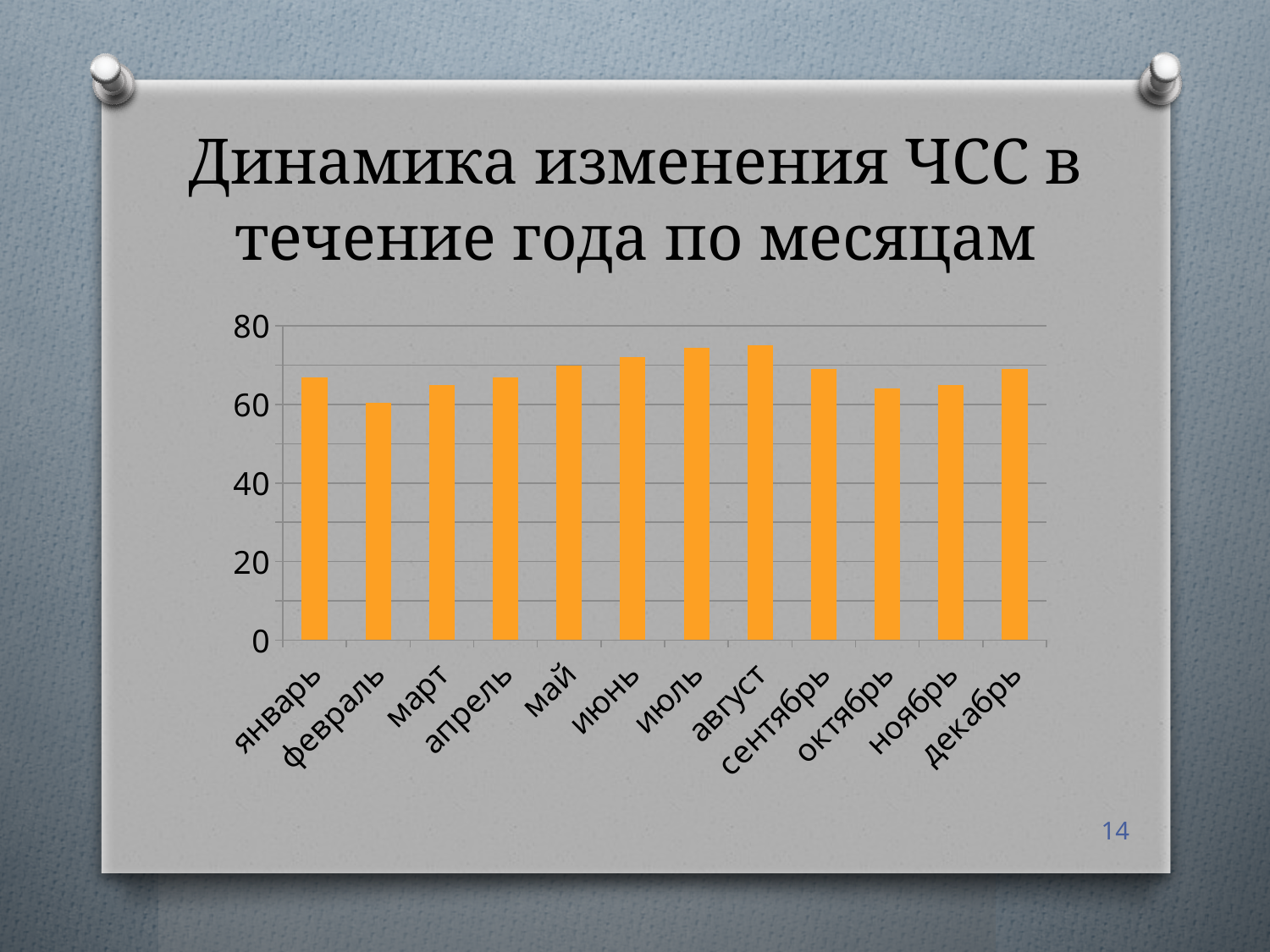
Is the value for май greater or less than 60? greater Which is larger, the value for июнь or the value for октябрь? июнь Is the value for октябрь greater or less than 60? greater What kind of chart is shown on the slide? bar chart Which is larger, the value for июль or the value for февраль? июль Which month has the lowest value on the chart? февраль Is the value for январь greater or less than 60? greater What is the title of the slide containing the chart? Динамика изменения ЧСС в течение года по месяцам Do the values rise or fall from февраль to август? rise Which is larger, the value for май or the value for март? май How many months (categories) are plotted on the chart? 12